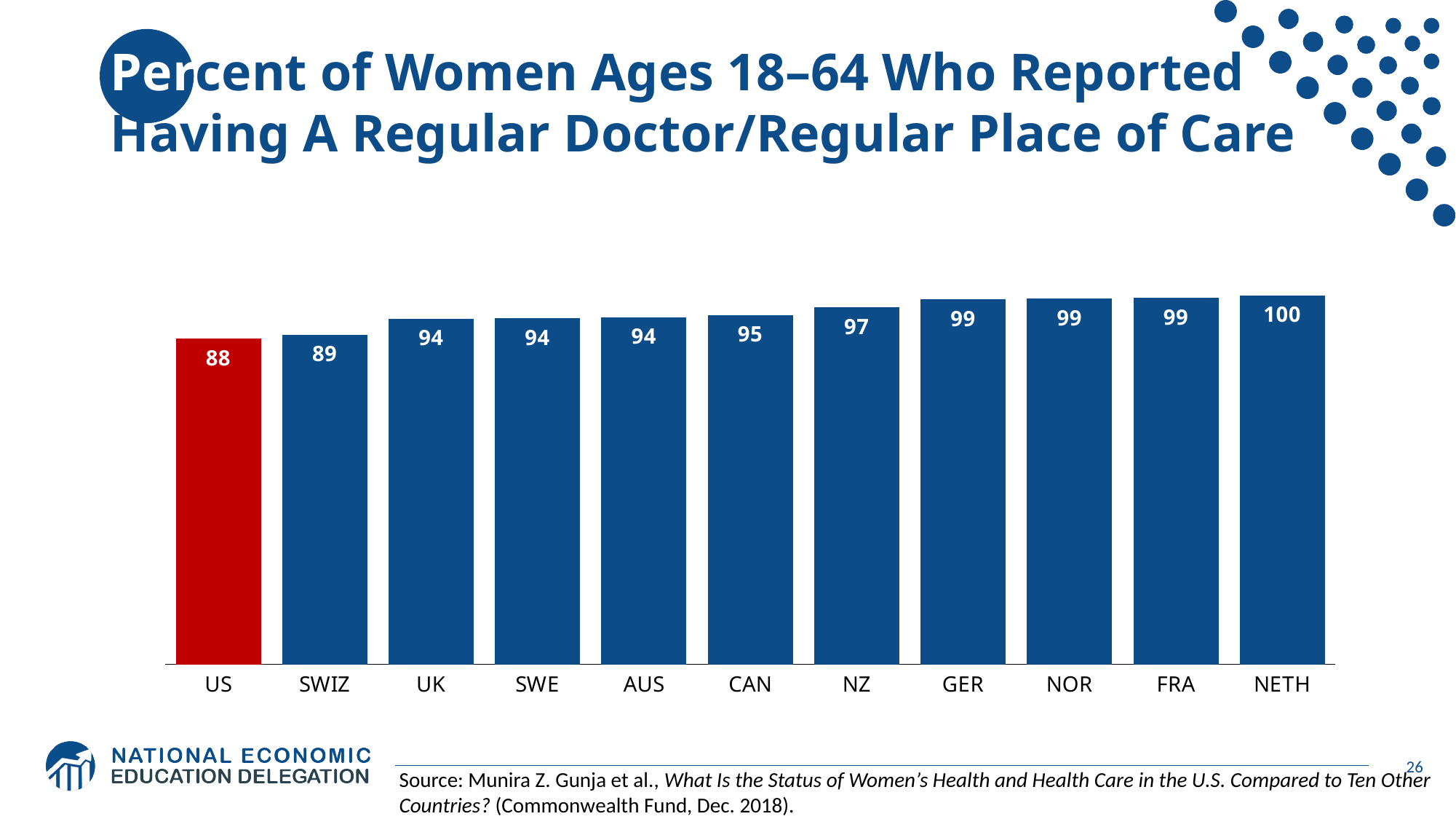
What is the difference between the values for NETH and the US? 12 Which has a larger value, SWIZ or CAN? CAN What is the value for NZ? 97 Which country has the lowest value? US Which country has the highest value? NETH What is the value for CAN? 95 What is the difference between the values for SWIZ and UK? 5 What kind of chart is shown on the slide? bar chart What is the value for the US? 88 Do the values rise or fall from left to right across the chart? rise How many countries are shown in the chart? 11 Which bar is coloured red rather than blue? US